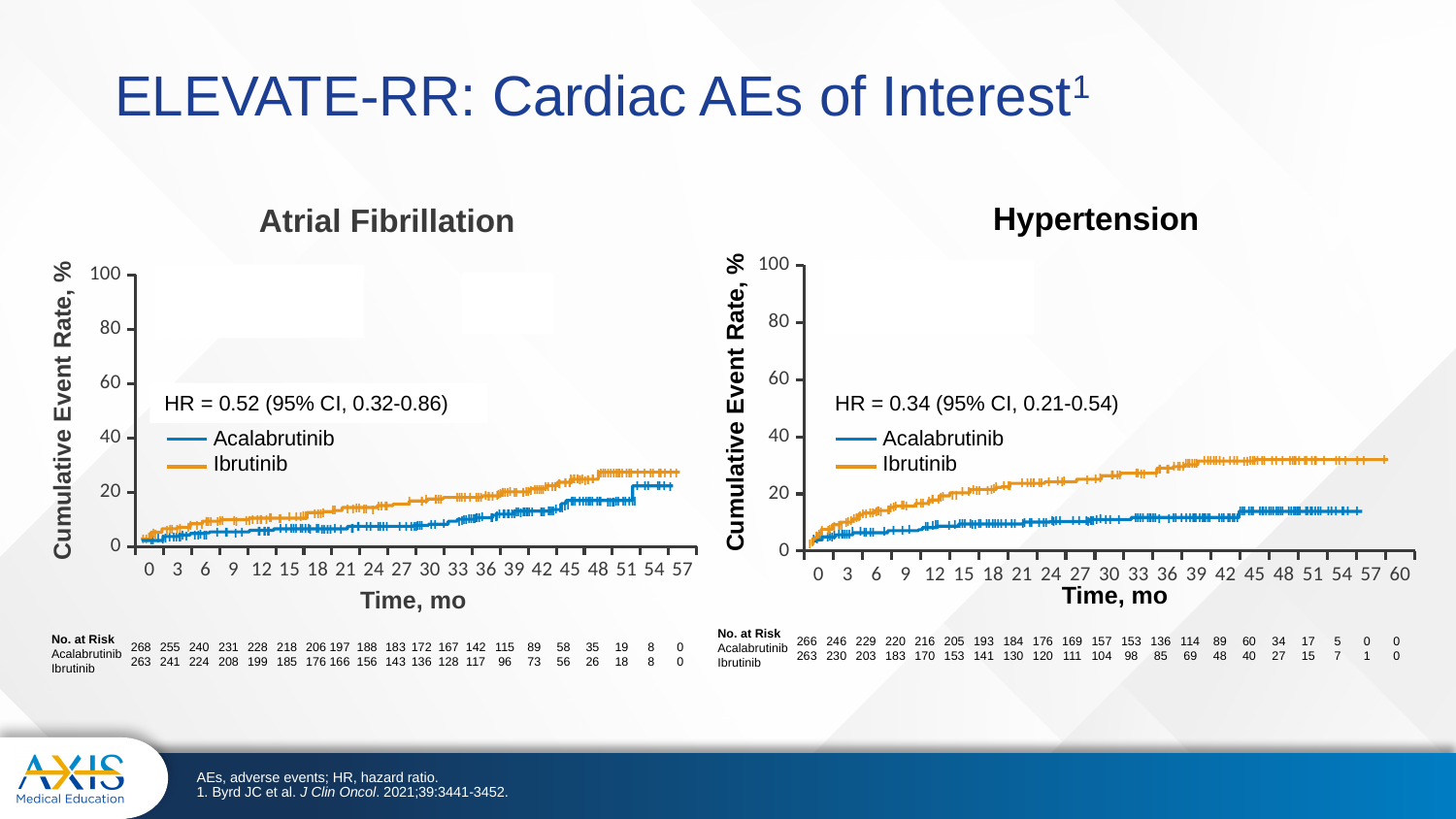
What kind of chart is the Atrial Fibrillation chart? Line chart In the Atrial Fibrillation chart, what is the difference between the number at risk for Acalabrutinib and Ibrutinib at 0 months? 5 In the Hypertension chart, which series has the higher cumulative event rate at 48 months, Acalabrutinib or Ibrutinib? Ibrutinib In the Atrial Fibrillation chart, what is the number at risk for Acalabrutinib at 0 months? 268 In the Atrial Fibrillation chart, what hazard ratio is shown? HR = 0.52 (95% CI, 0.32-0.86) In the Atrial Fibrillation chart, is the cumulative event rate for Acalabrutinib at 48 months greater or less than 20? less In the Hypertension chart, does the cumulative event rate for Ibrutinib rise or fall as time increases? Rise How many series does the legend of the Hypertension chart list? 2 In the Hypertension chart, is the cumulative event rate for Ibrutinib at 57 months greater or less than 20? greater In the Hypertension chart, what is the number at risk for Ibrutinib at 0 months? 263 In the Atrial Fibrillation chart, is the cumulative event rate for Ibrutinib at 57 months greater or less than 20? greater In the Hypertension chart, what hazard ratio is shown? HR = 0.34 (95% CI, 0.21-0.54)